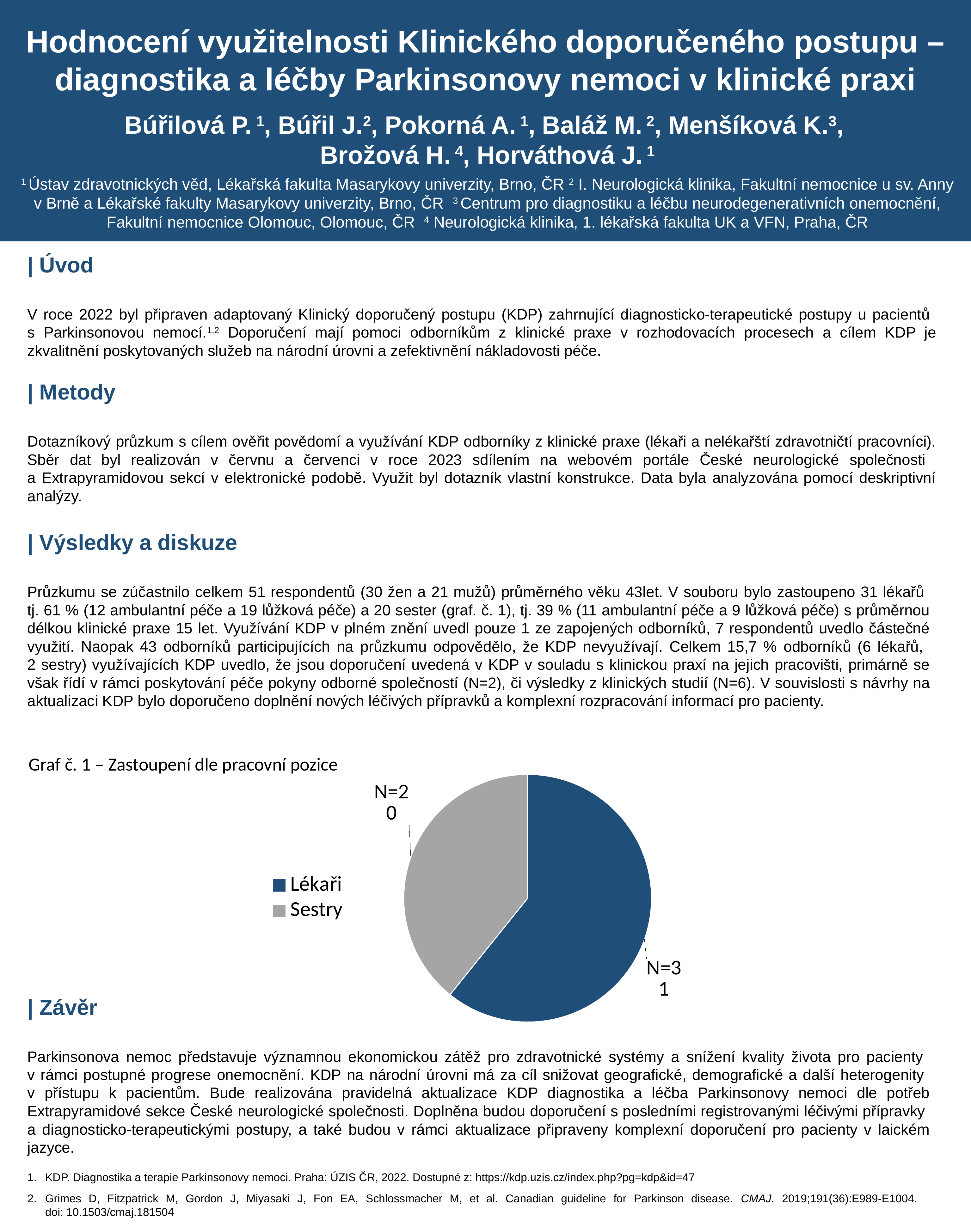
What value is shown for Sestry in the pie chart? N=20 Which category has the smallest slice in the pie chart? Sestry What is the total of the two values shown in the pie chart? 51 What is the difference between the number of Lékaři and the number of Sestry in the pie chart? 11 How many entries does the legend of the pie chart list? 2 Which category has the largest slice in the pie chart? Lékaři How many categories does the pie chart show? 2 What is the title of the chart on the slide? Graf č. 1 – Zastoupení dle pracovní pozice What kind of chart is shown on the slide? Pie chart Which is larger in the pie chart, Lékaři or Sestry? Lékaři What value is shown for Lékaři in the pie chart? N=31 What colour is the Sestry slice in the pie chart? Grey